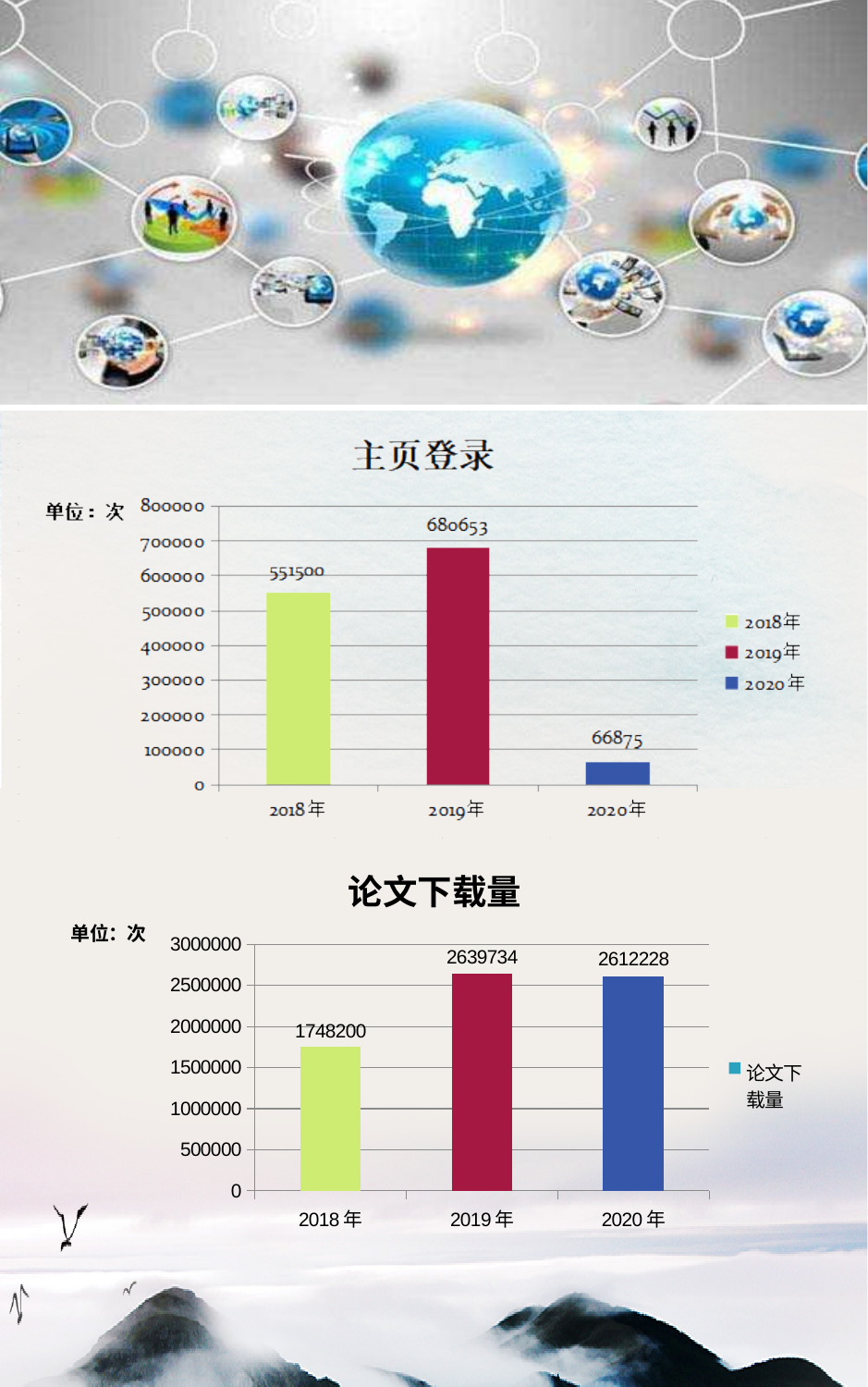
In the 论文下载量 chart, what is the value for 2018 年? 1748200 In the 主页登录 chart, what is the value for 2019年? 680653 In the 论文下载量 chart, which is larger, the value for 2018 年 or 2020 年? 2020 年 In the 主页登录 chart, which year has the lowest value? 2020年 In the 主页登录 chart, how many entries does the legend list? 3 In the 主页登录 chart, which year has the highest value? 2019年 In the 主页登录 chart, what is the difference between the 2019年 and 2018年 values? 129153 In the 主页登录 chart, what is the value for 2020年? 66875 In the 论文下载量 chart, what is the difference between the 2019 年 and 2020 年 values? 27506 In the 论文下载量 chart, what is the value for 2019 年? 2639734 What kind of chart is the 论文下载量 chart? bar chart In the 论文下载量 chart, is the value for 2018 年 greater or less than 2000000? less